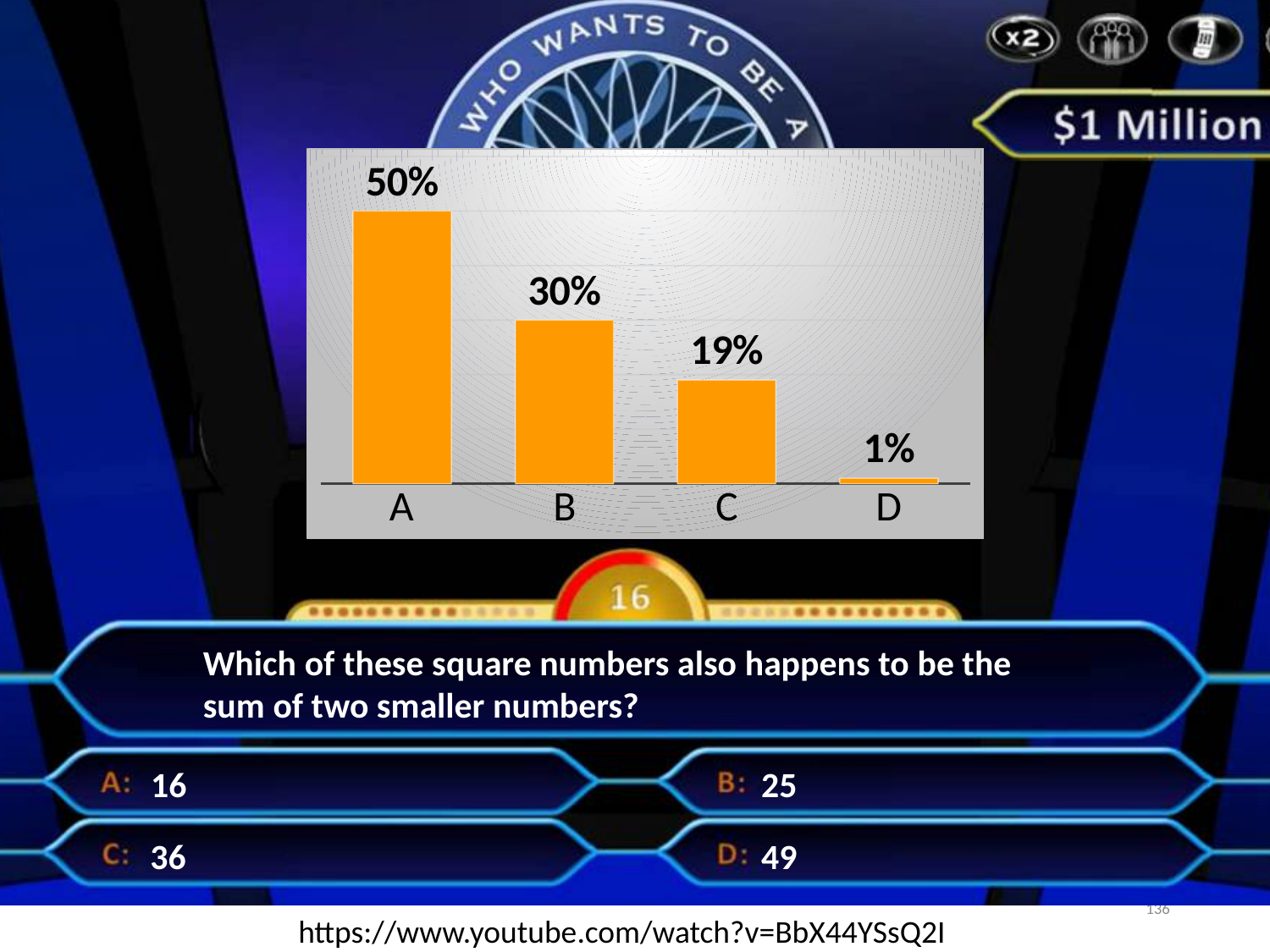
What is the difference between the values for A and B? 20% What is the value for category D? 1% What is the value for category B? 30% Do the values rise or fall from A to D along the x axis? Fall What is the value for category A? 50% How many categories are shown on the chart? 4 Which is larger, the value for B or the value for C? B What is the difference between the values for C and D? 18% Which category has the lowest value? D What kind of chart is shown on the slide? Bar chart What is the value for category C? 19% Which category has the highest value? A